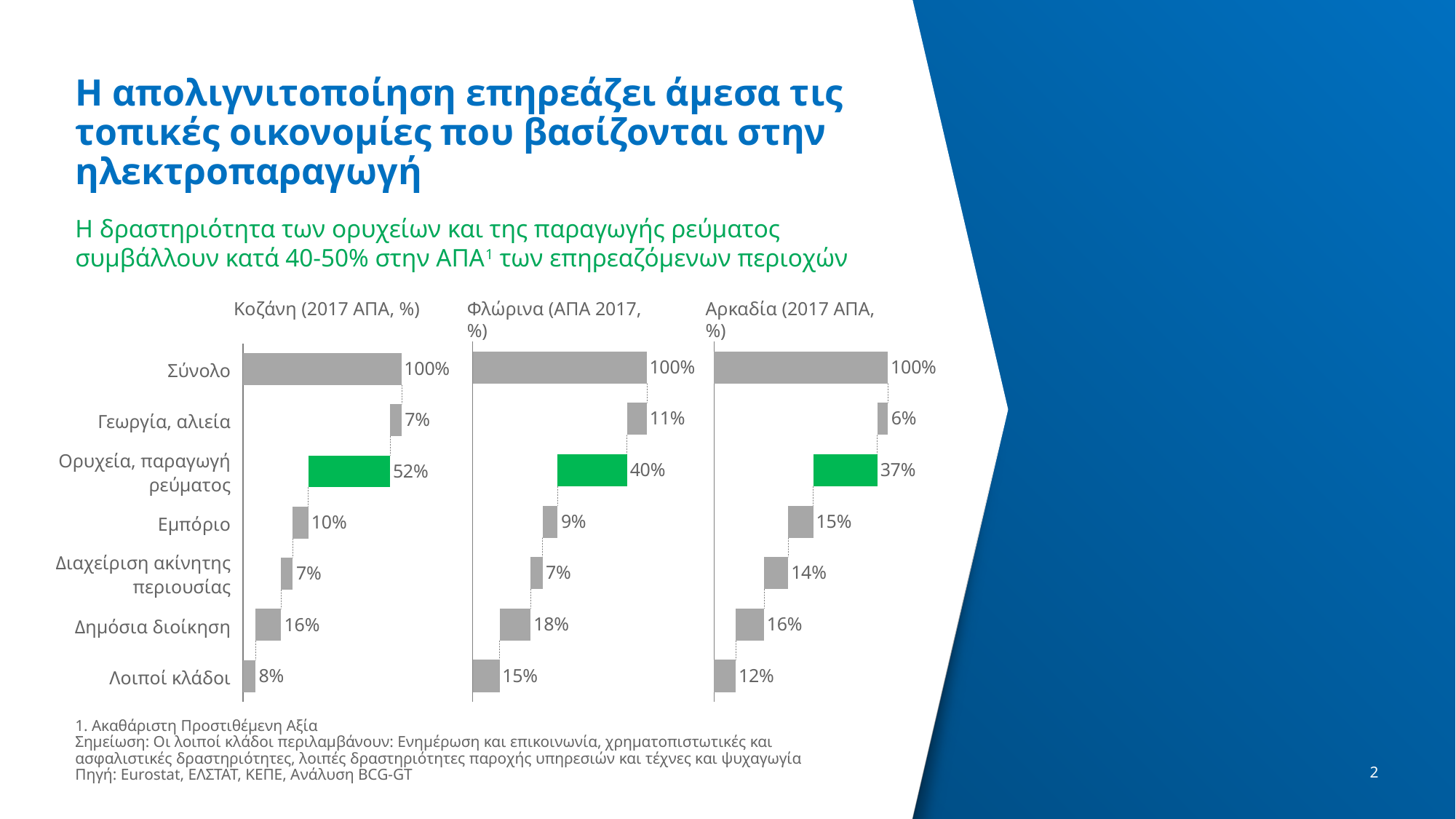
In the Αρκαδία (2017 ΑΠΑ, %) chart, what is the value for Γεωργία, αλιεία? 6% In the Κοζάνη (2017 ΑΠΑ, %) chart, what is the value for Ορυχεία, παραγωγή ρεύματος? 52% In the Κοζάνη (2017 ΑΠΑ, %) chart, excluding Σύνολο, which category has the highest value? Ορυχεία, παραγωγή ρεύματος In the Αρκαδία (2017 ΑΠΑ, %) chart, what is the value for Εμπόριο? 15% What type of chart is used for Φλώρινα (ΑΠΑ 2017, %)? Bar chart Which is larger: Ορυχεία, παραγωγή ρεύματος in the Φλώρινα chart or in the Αρκαδία chart? Φλώρινα How many categories are shown in the Κοζάνη (2017 ΑΠΑ, %) chart? 7 In the Φλώρινα (ΑΠΑ 2017, %) chart, which category has the lowest value? Διαχείριση ακίνητης περιουσίας In the Κοζάνη (2017 ΑΠΑ, %) chart, what is the difference between Ορυχεία, παραγωγή ρεύματος and Δημόσια διοίκηση? 36 percentage points In the Φλώρινα (ΑΠΑ 2017, %) chart, what is the value for Δημόσια διοίκηση? 18% In the Αρκαδία (2017 ΑΠΑ, %) chart, which is larger: Εμπόριο or Λοιποί κλάδοι? Εμπόριο In the Κοζάνη (2017 ΑΠΑ, %) chart, which category's bar is coloured green? Ορυχεία, παραγωγή ρεύματος